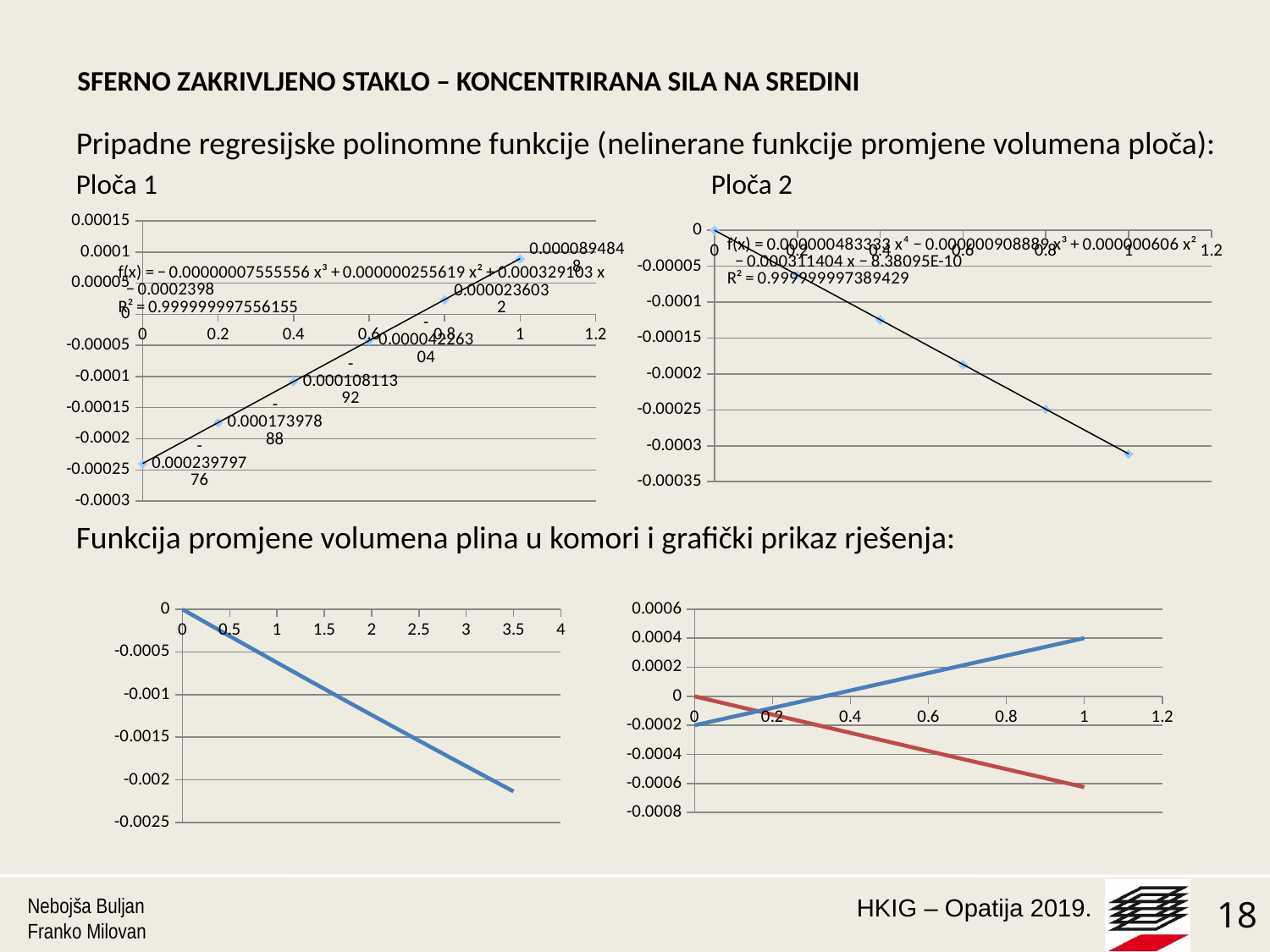
In the 'Ploča 2' chart, is the value at x = 1 greater or less than -0.0003? less What kind of chart is the 'Ploča 1' chart? scatter chart In the 'Ploča 1' chart, do the values rise or fall as x increases? rise What R² value is shown on the 'Ploča 2' chart? 0.999999997389429 In the bottom-left chart, is the value at x = 3.5 greater or less than -0.002? less In the 'Ploča 1' chart, what is the data label of the point at x = 0.8? 0.0000236032 How many data points are plotted in the 'Ploča 1' chart? 6 In the 'Ploča 1' chart, what is the data label of the point at x = 0? -0.00023979776 In the 'Ploča 2' chart, do the values rise or fall as x increases? fall In the 'Ploča 1' chart, what is the data label of the point at x = 1? 0.0000894848 In the 'Ploča 1' chart, at which x value is the plotted value highest? 1 In the bottom-right chart, how many lines are plotted? 2